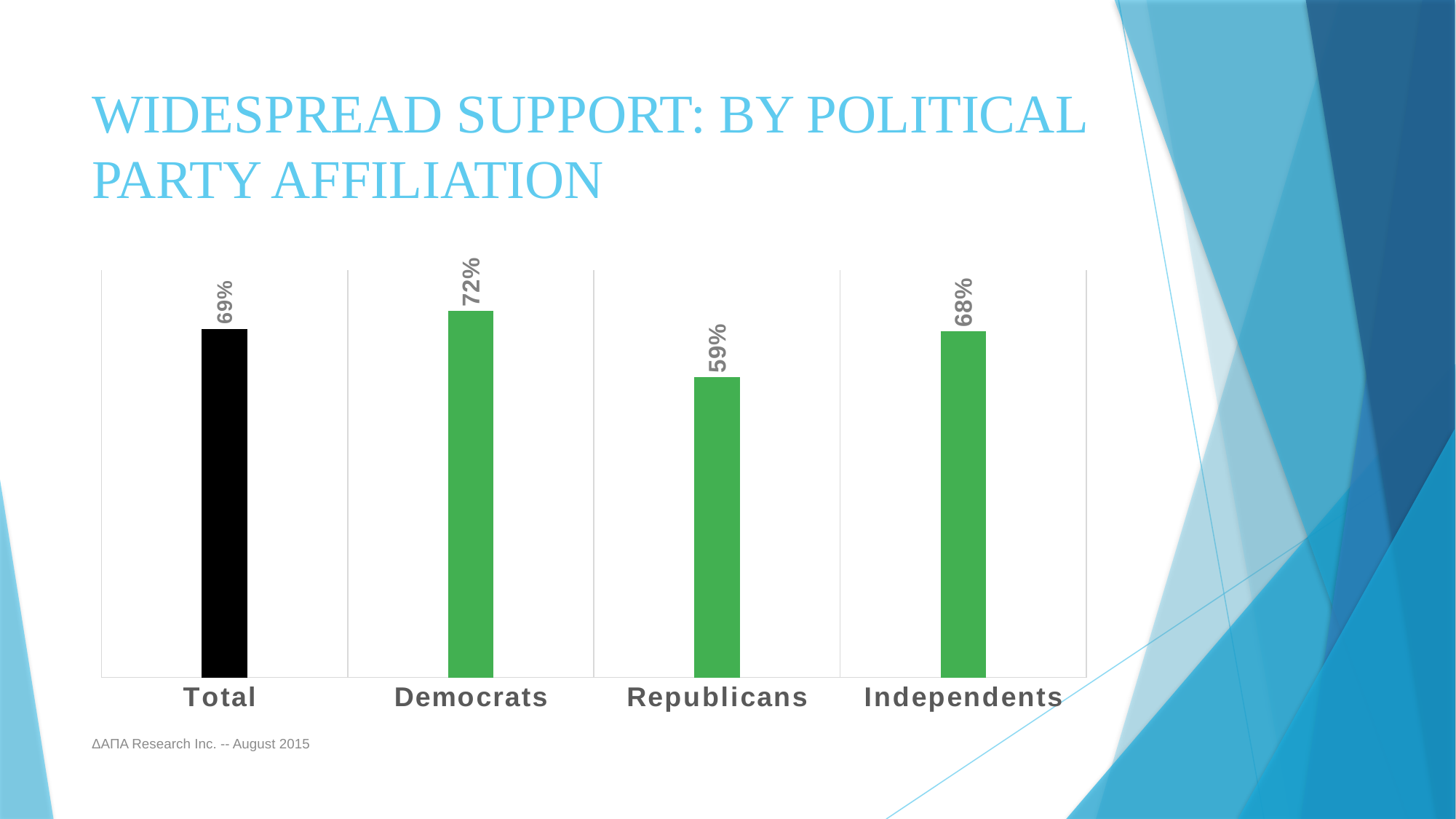
What is the value for Total? 69% What is the value for Independents? 68% What is the value for Democrats? 72% Which is larger, the value for Republicans or the value for Independents? Independents What kind of chart is shown on the slide? Bar chart What is the difference between the values for Democrats and Republicans? 13% What is the difference between the values for Total and Independents? 1% Which category has the lowest value? Republicans What is the value for Republicans? 59% Which category has the highest value? Democrats Which bar is coloured black? Total How many categories are shown in the chart? 4